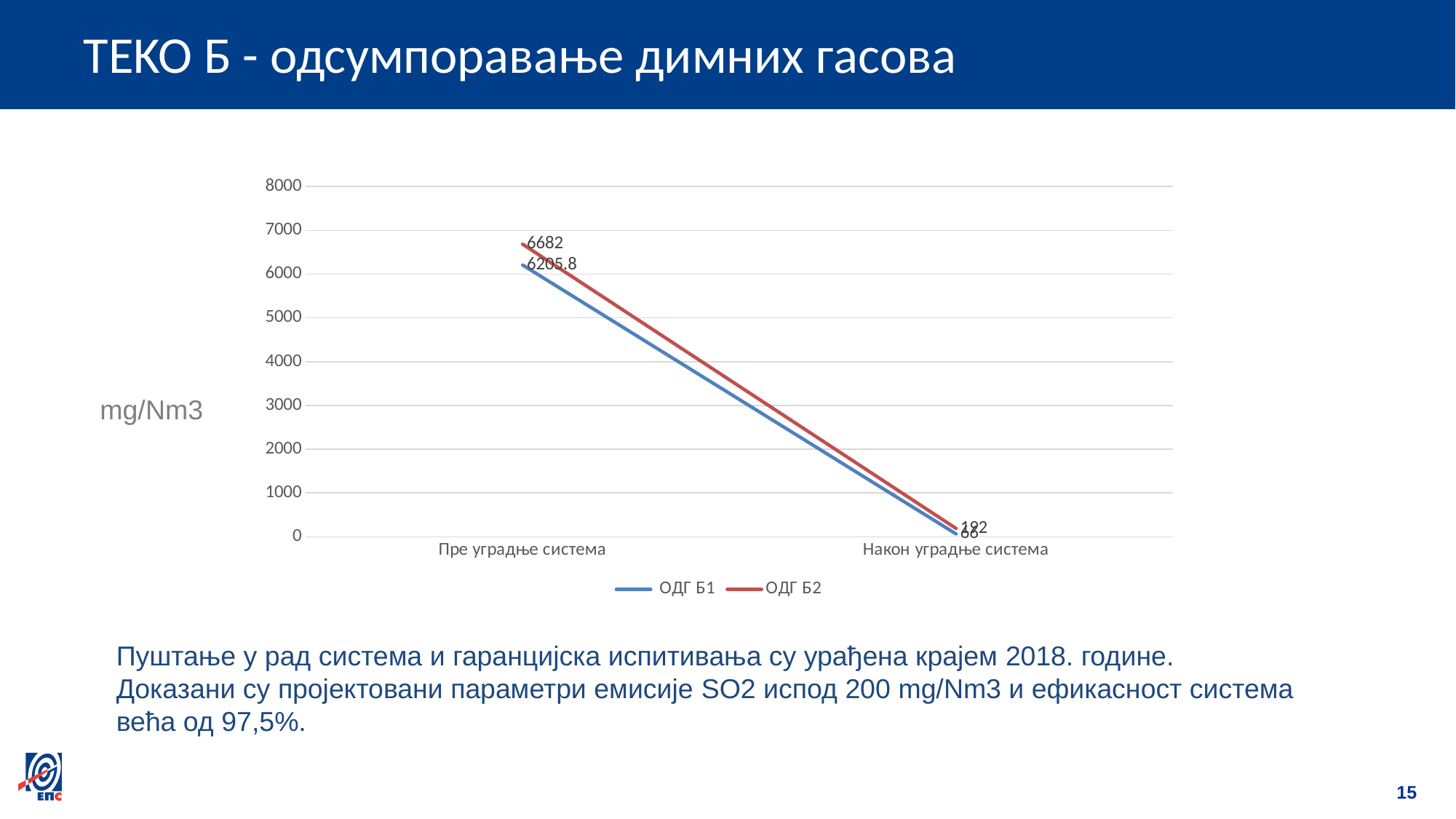
What is the value for ОДГ Б1 at "Пре уградње система"? 6205.8 Is the value for ОДГ Б2 at "Пре уградње система" greater or less than 6000? greater What kind of chart is shown on the slide? line chart What unit is shown next to the vertical axis of the chart? mg/Nm3 At "Пре уградње система", which series has the higher value, ОДГ Б1 or ОДГ Б2? ОДГ Б2 How many series does the chart legend list? 2 Is the value for ОДГ Б1 at "Након уградње система" greater or less than 1000? less How many categories are shown on the x axis of the chart? 2 What is the value for ОДГ Б2 at "Пре уградње система"? 6682 Do the values rise or fall from "Пре уградње система" to "Након уградње система"? fall Which series is drawn in red in the chart? ОДГ Б2 What is the difference between the ОДГ Б2 and ОДГ Б1 values at "Пре уградње система"? 476.2